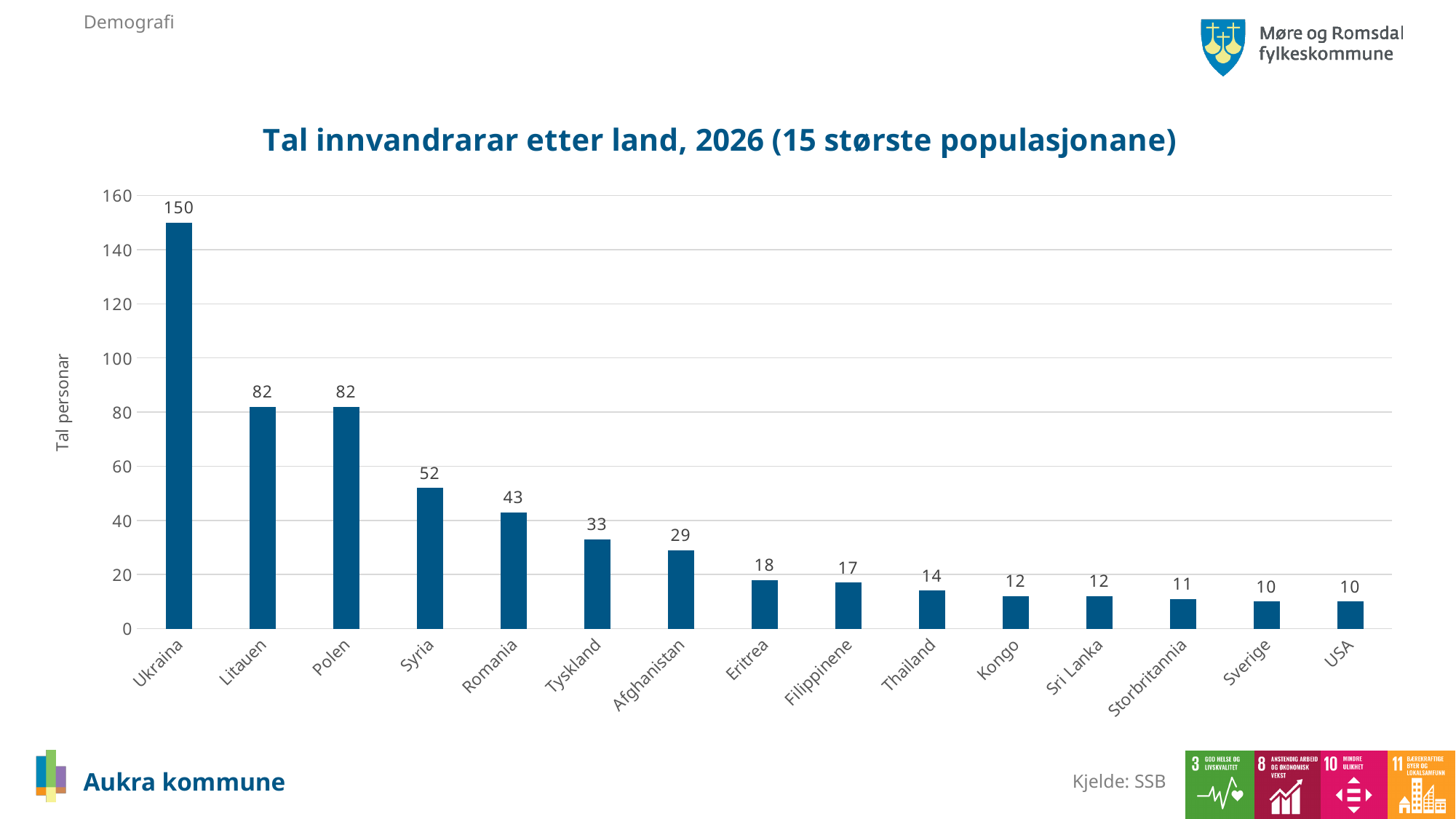
Do the values rise or fall from left to right along the x axis? fall What is the value for Afghanistan? 29 What kind of chart is this? bar chart What is the difference between the values for Romania and Tyskland? 10 Which is larger, the value for Eritrea or the value for Thailand? Eritrea What is the value for Syria? 52 Is the value for Polen greater or less than 100? less How many countries are shown on the chart? 15 What is the difference between the values for Ukraina and Litauen? 68 What is the title of the chart? Tal innvandrarar etter land, 2026 (15 største populasjonane) What is the value for Ukraina? 150 Which country has the highest value? Ukraina